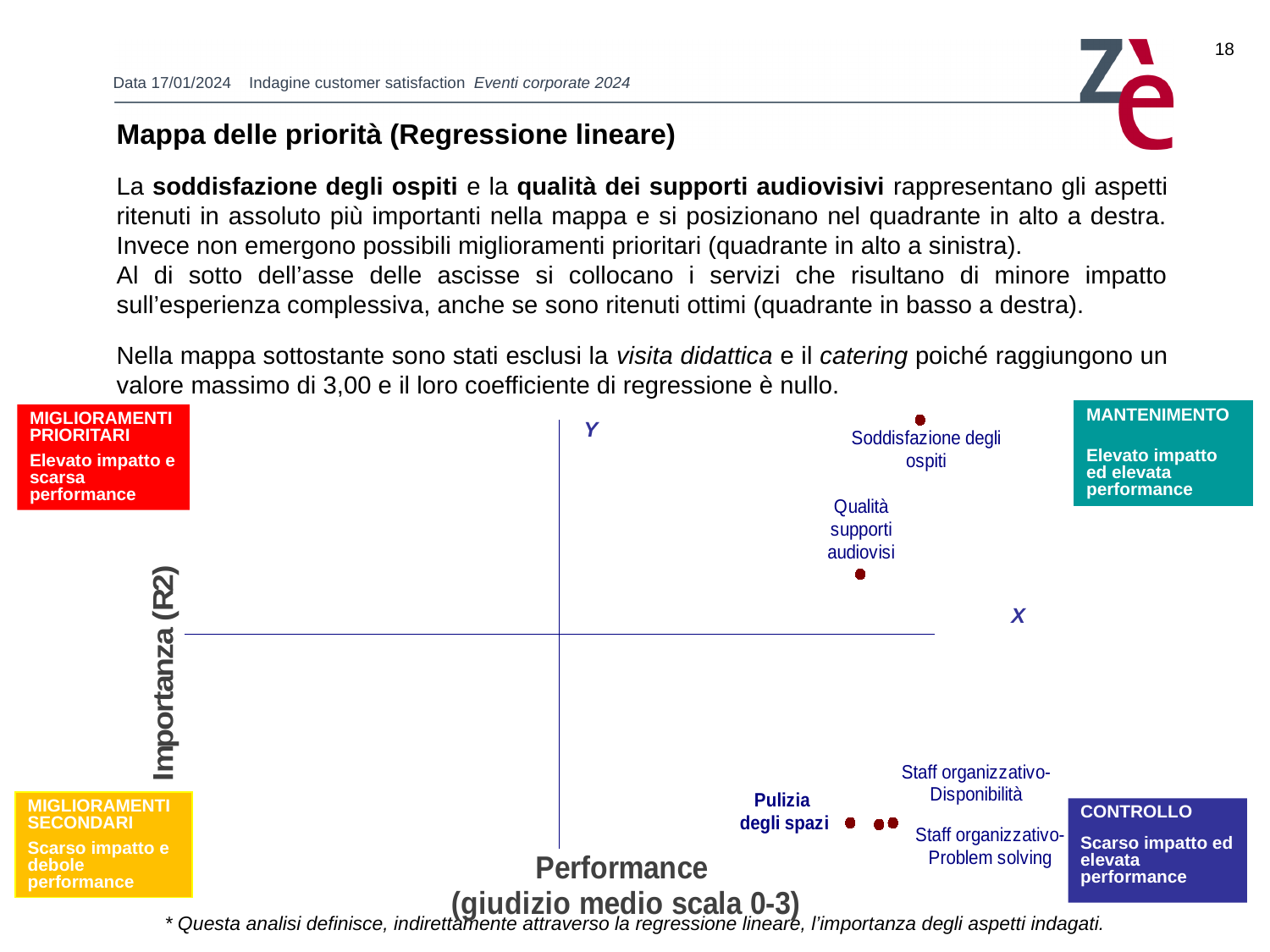
Which has higher performance: Pulizia degli spazi or Staff organizzativo-Problem solving? Staff organizzativo-Problem solving How many data points are plotted on the priority map? 5 What kind of chart is shown on the slide? scatter plot How many data points lie above the horizontal (X) axis on the priority map? 2 Which point has the highest importance (R2) on the priority map? Soddisfazione degli ospiti What is the name of the top-right quadrant of the priority map? MANTENIMENTO What is the label of the horizontal axis of the priority map? Performance (giudizio medio scala 0-3) Which has higher importance (R2): Soddisfazione degli ospiti or Qualità supporti audiovisi? Soddisfazione degli ospiti How many data points lie below the horizontal (X) axis on the priority map? 3 Which has higher importance (R2): Pulizia degli spazi or Qualità supporti audiovisi? Qualità supporti audiovisi